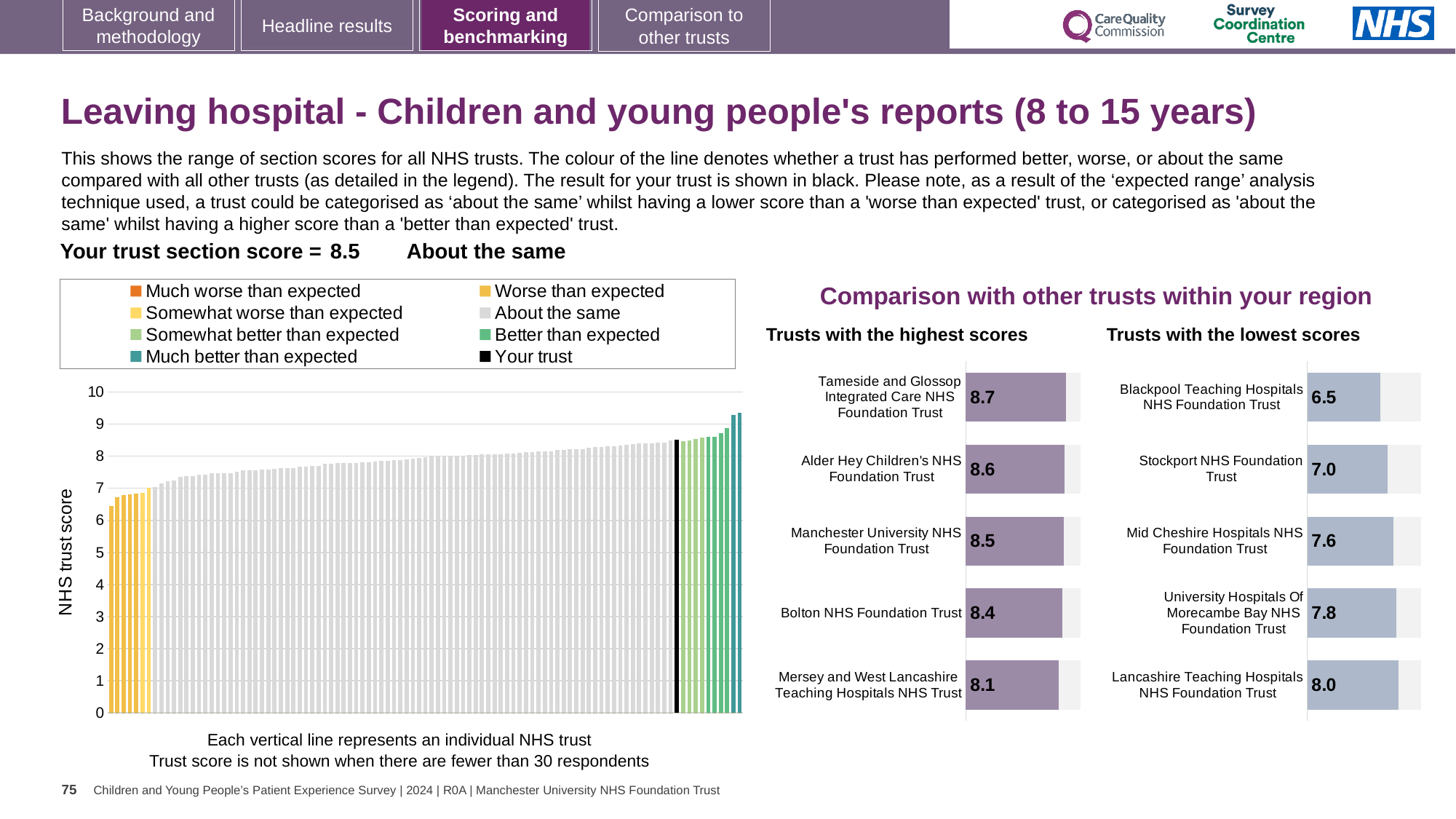
In the 'Trusts with the highest scores' chart, which trust has the highest score? Tameside and Glossop Integrated Care NHS Foundation Trust In the 'Trusts with the lowest scores' chart, which trust has the lowest score? Blackpool Teaching Hospitals NHS Foundation Trust In the 'Trusts with the lowest scores' chart, which has the higher score: Mid Cheshire Hospitals NHS Foundation Trust or University Hospitals Of Morecambe Bay NHS Foundation Trust? University Hospitals Of Morecambe Bay NHS Foundation Trust In the main chart on the left, do the trust scores rise or fall from left to right? rise In the main chart on the left showing the range of section scores, what is the score for your trust (the black bar)? 8.5 How many trusts are listed in the 'Trusts with the highest scores' chart? 5 How many entries does the legend of the main chart on the left list? 8 In the 'Trusts with the highest scores' chart, what is the score for Tameside and Glossop Integrated Care NHS Foundation Trust? 8.7 What type of chart is the main chart on the left showing NHS trust scores? bar chart In the 'Trusts with the lowest scores' chart, what is the score for Stockport NHS Foundation Trust? 7.0 In the 'Trusts with the lowest scores' chart, what is the difference between the scores of Lancashire Teaching Hospitals NHS Foundation Trust and Blackpool Teaching Hospitals NHS Foundation Trust? 1.5 In the 'Trusts with the highest scores' chart, what is the difference between the scores of Tameside and Glossop Integrated Care NHS Foundation Trust and Mersey and West Lancashire Teaching Hospitals NHS Trust? 0.6